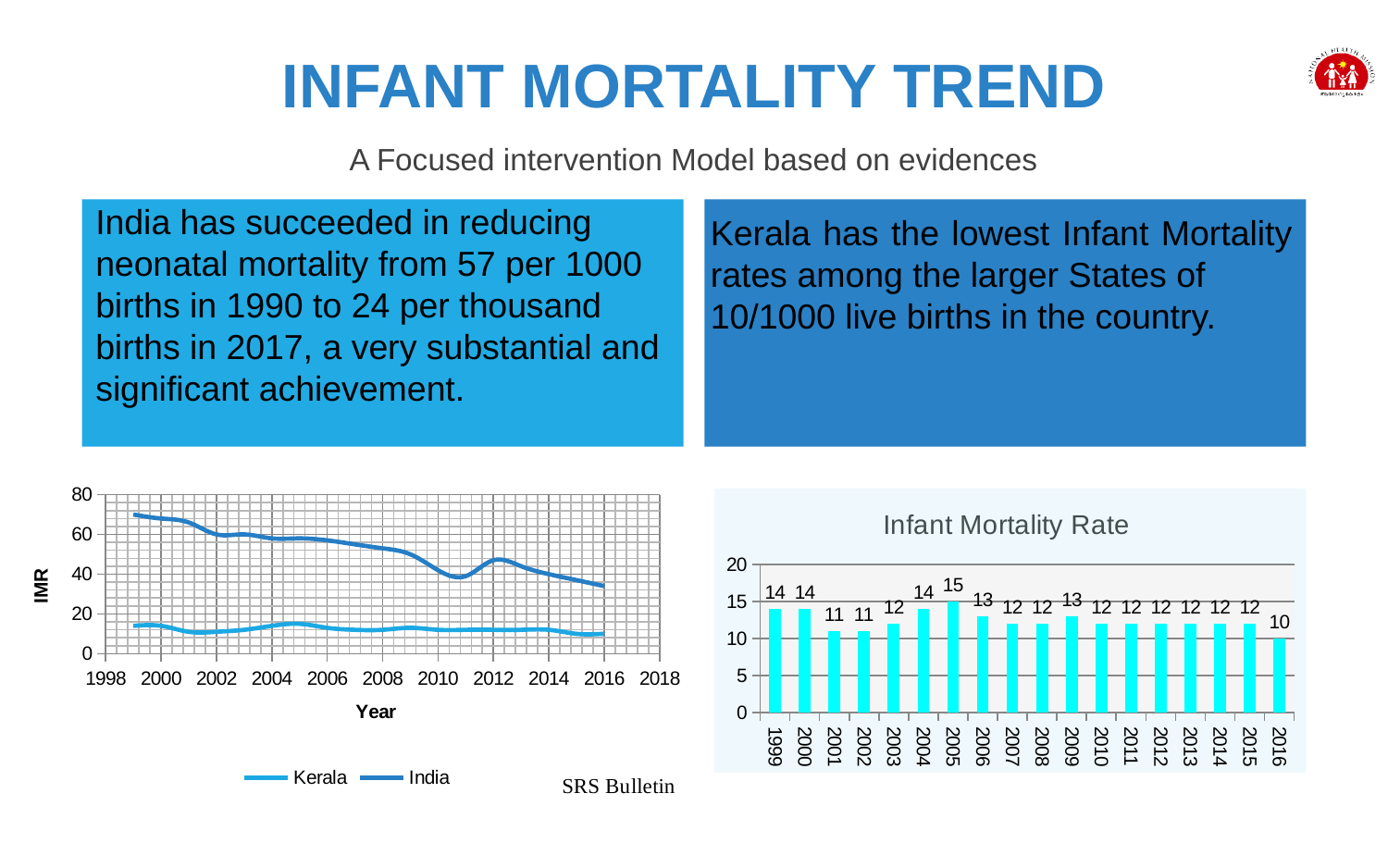
In the Infant Mortality Rate bar chart, which year has the highest value? 2005 What kind of chart is the Infant Mortality Rate chart on the right of the slide? bar chart In the left-hand line chart, is the value for India in 1999 greater or less than 60? greater In the Infant Mortality Rate bar chart, which year has the lowest value? 2016 In the left-hand line chart, does the India series rise or fall from 1999 to 2016? fall What kind of chart is the chart on the left of the slide with the Year axis? line chart How many series does the legend of the left-hand line chart list? 2 How many bars are plotted in the Infant Mortality Rate bar chart? 18 In the Infant Mortality Rate bar chart, what is the difference between the values for 2005 and 2016? 5 In the Infant Mortality Rate bar chart, what is the value for 2005? 15 In the Infant Mortality Rate bar chart, which is larger, the value for 1999 or the value for 2001? 1999 In the Infant Mortality Rate bar chart, what is the value for 2016? 10